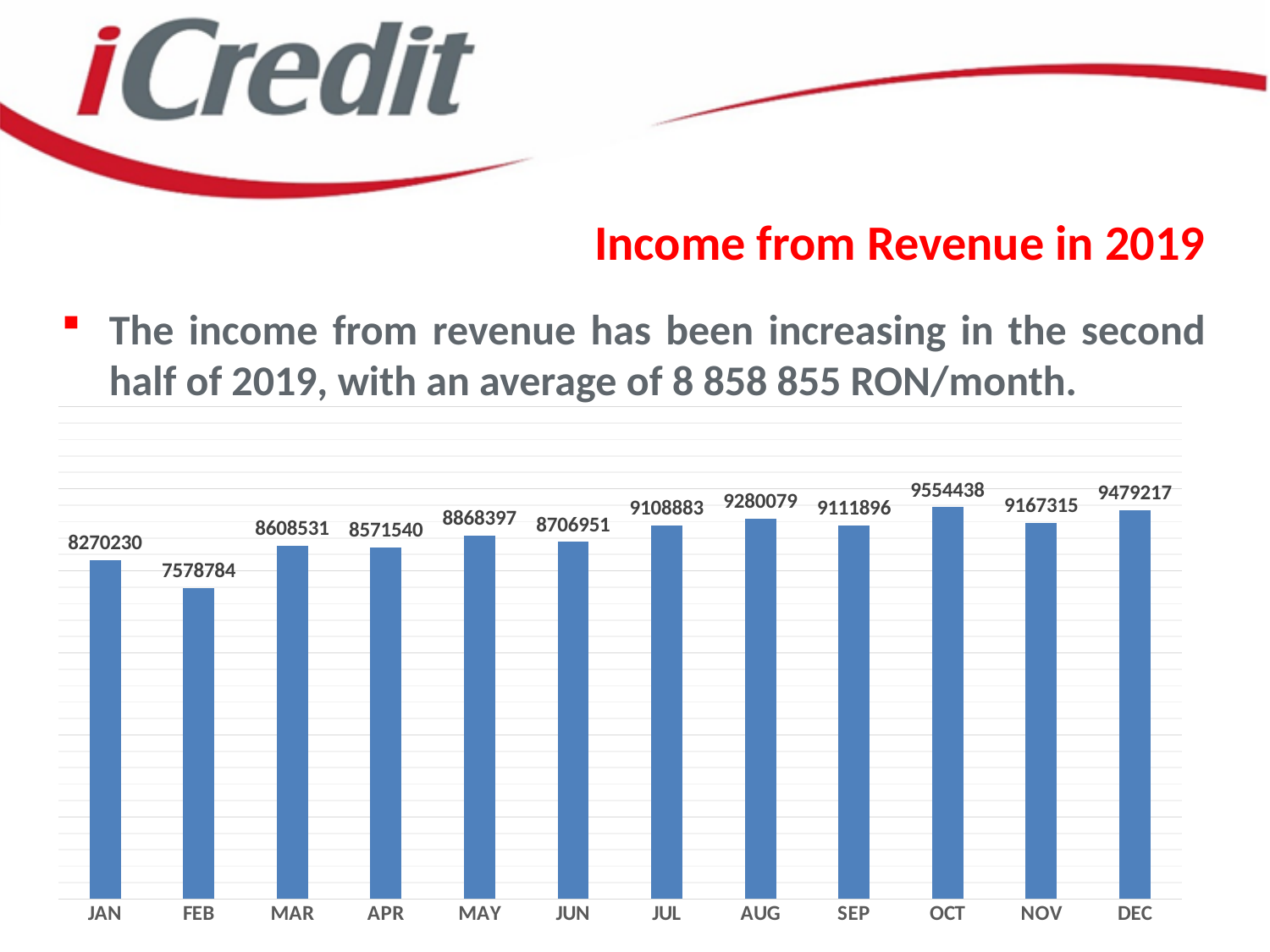
What is the difference between the values for OCT and FEB? 1975654 Which month has the lowest value? FEB Which month has the highest value? OCT What kind of chart is shown on the slide? Bar chart What is the value for FEB? 7578784 What is the value for JUL? 9108883 Which is larger, the value for AUG or the value for SEP? AUG What is the value for OCT? 9554438 Do the values generally rise or fall from JAN to DEC? Rise Which is larger, the value for MAY or the value for JUN? MAY What is the difference between the values for DEC and JAN? 1208987 How many months are shown on the x axis? 12